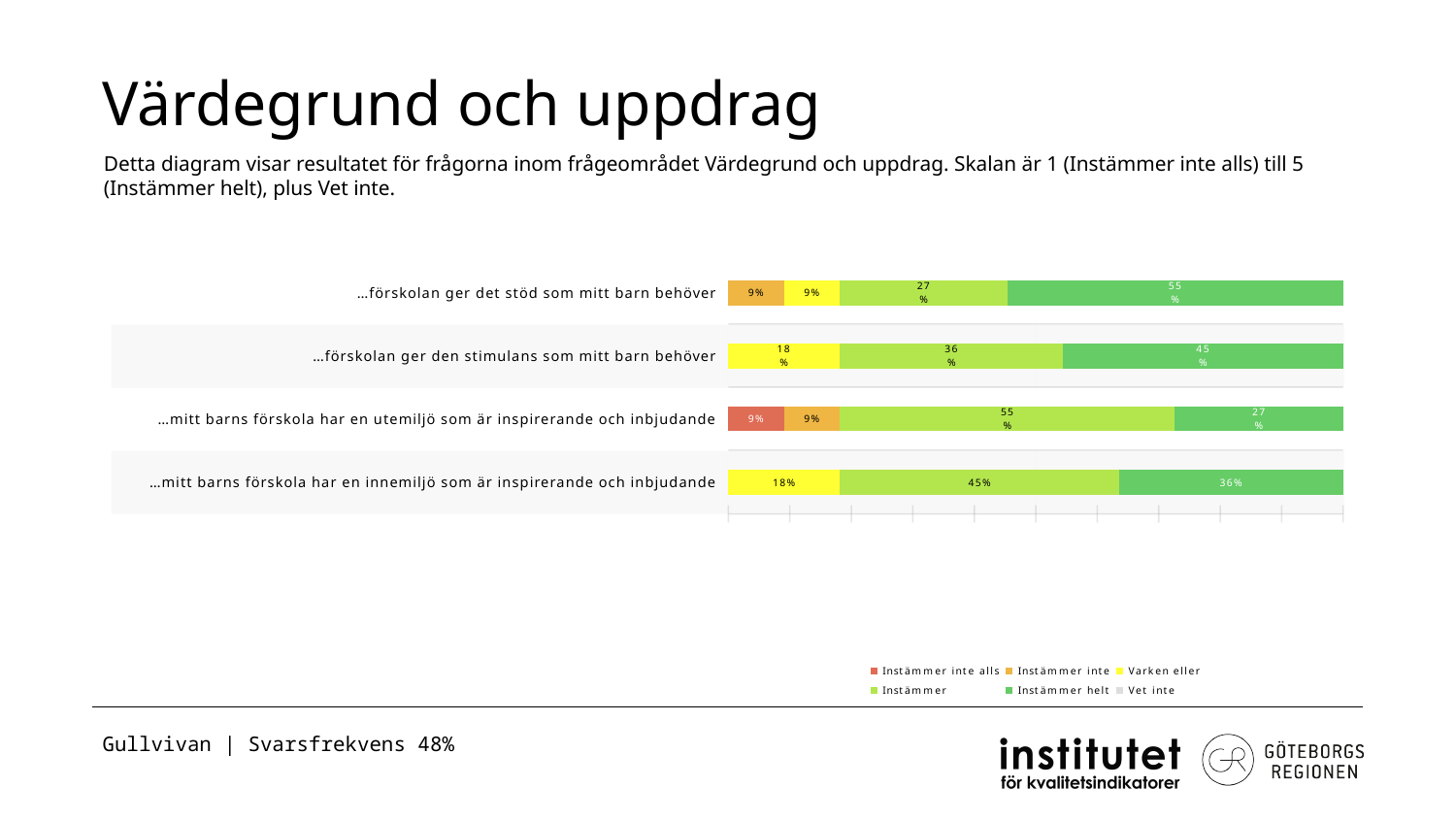
What is the value of "Instämmer" for "…mitt barns förskola har en utemiljö som är inspirerande och inbjudande"? 55% What is the value of "Instämmer helt" for "…förskolan ger det stöd som mitt barn behöver"? 55% How many categories (questions) are shown in the chart? 4 What is the value of "Instämmer helt" for "…mitt barns förskola har en innemiljö som är inspirerande och inbjudande"? 36% How many series does the legend list? 6 What kind of chart is shown on the slide? Stacked bar chart Which category is the only one with an "Instämmer inte alls" segment? …mitt barns förskola har en utemiljö som är inspirerande och inbjudande Which category has the lowest "Instämmer helt" value? …mitt barns förskola har en utemiljö som är inspirerande och inbjudande What is the difference between the "Instämmer helt" values for "…förskolan ger den stimulans som mitt barn behöver" and "…mitt barns förskola har en innemiljö som är inspirerande och inbjudande"? 9% What is the value of "Varken eller" for "…förskolan ger den stimulans som mitt barn behöver"? 18% Which category has the highest "Instämmer helt" value? …förskolan ger det stöd som mitt barn behöver Which is larger: the "Instämmer" value for "…förskolan ger den stimulans som mitt barn behöver" or for "…mitt barns förskola har en innemiljö som är inspirerande och inbjudande"? …mitt barns förskola har en innemiljö som är inspirerande och inbjudande